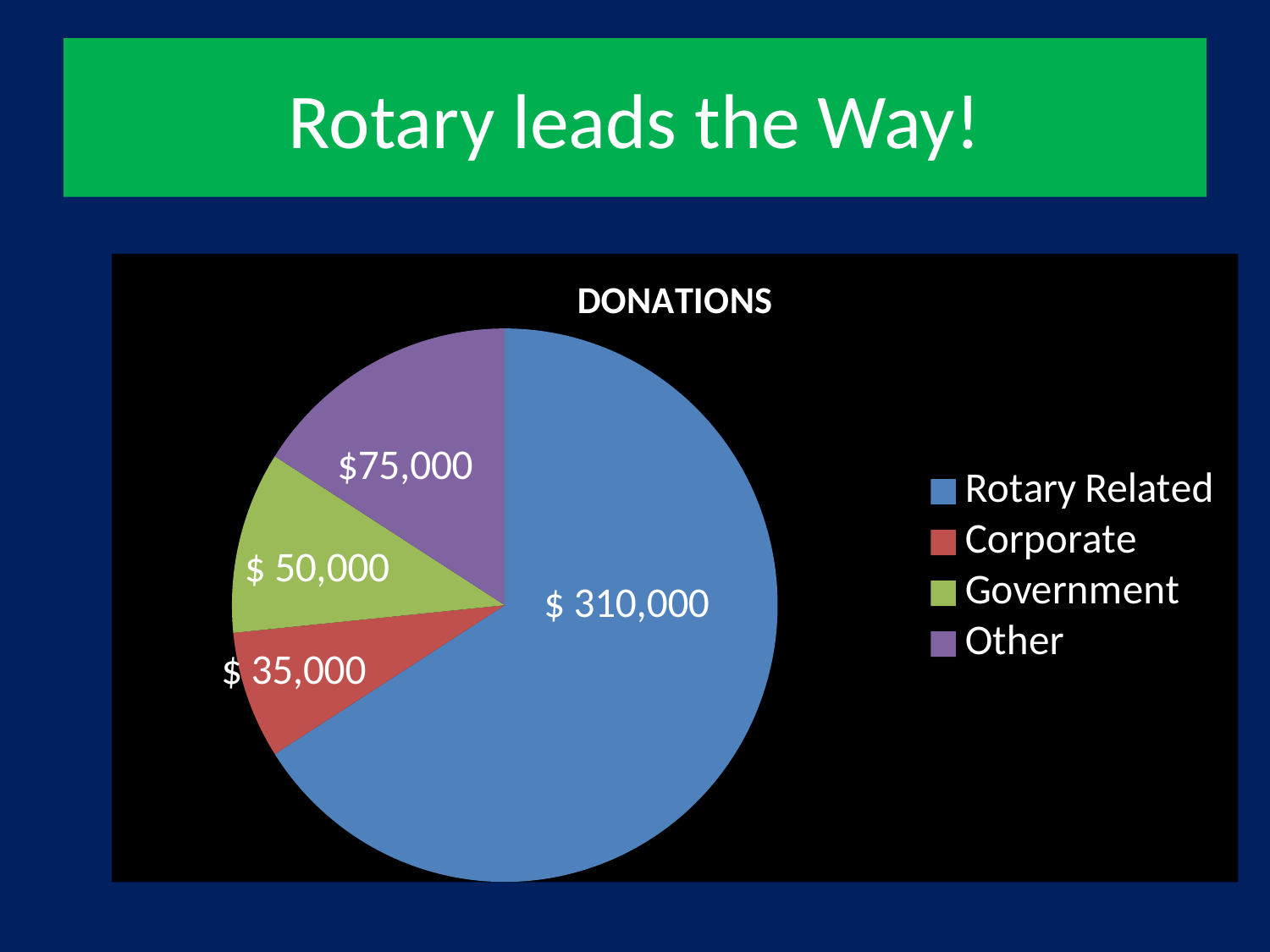
What type of chart is shown on the slide? Pie chart What is the title of the chart on the slide? DONATIONS What is the value of the Other slice in the DONATIONS pie chart? $75,000 What is the difference between the Rotary Related and Other donation values? $235,000 How many categories are shown in the DONATIONS pie chart? 4 Which is larger, the Government slice or the Other slice? Other Which category has the largest slice in the DONATIONS pie chart? Rotary Related What is the value of the Government slice in the DONATIONS pie chart? $ 50,000 What is the difference between the Government and Corporate donation values? $15,000 Which category has the smallest slice in the DONATIONS pie chart? Corporate What is the value of the Corporate slice in the DONATIONS pie chart? $ 35,000 What is the value of the Rotary Related slice in the DONATIONS pie chart? $ 310,000